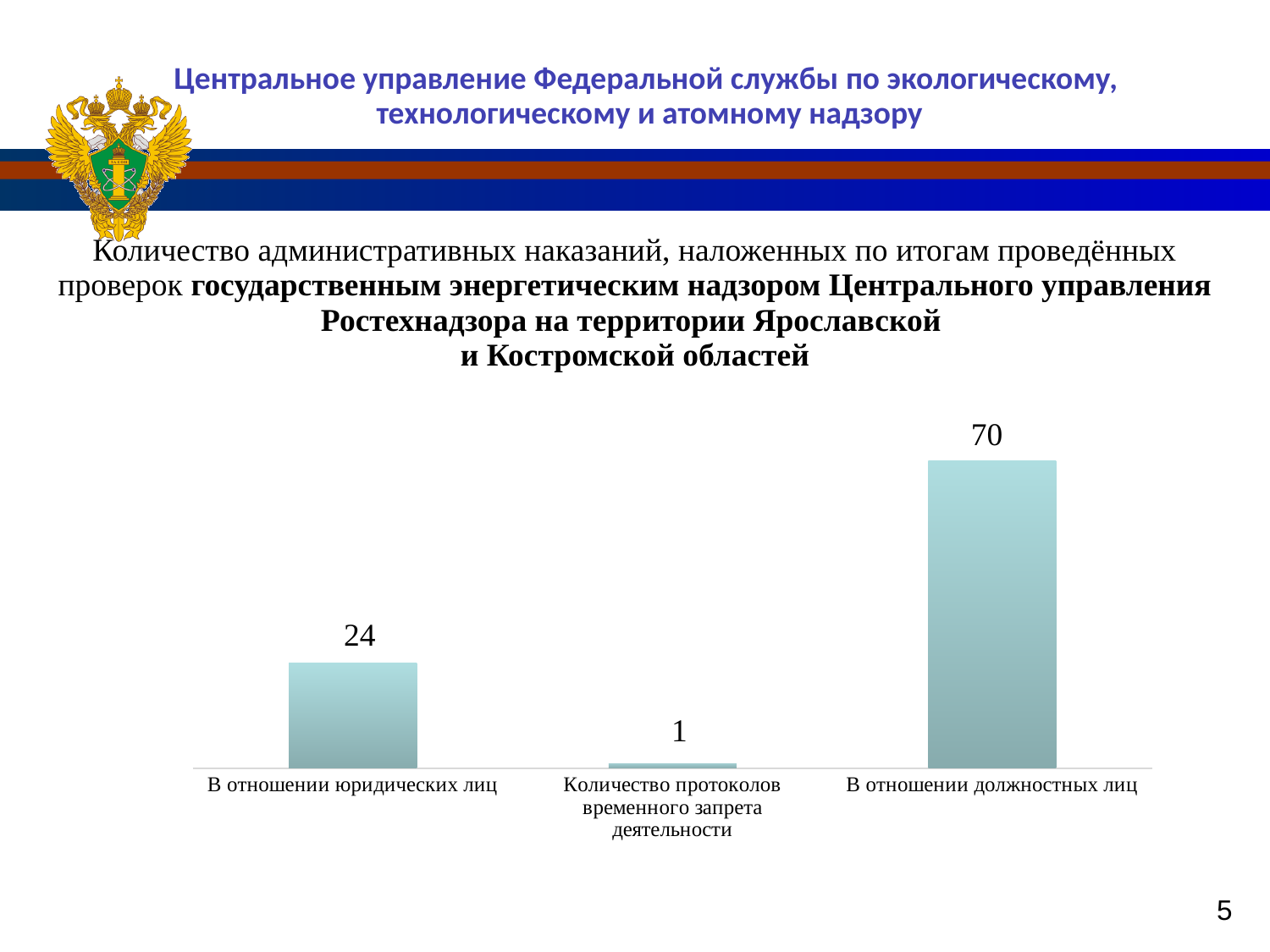
Which category has the highest value? В отношении должностных лиц Which is larger: the value for «В отношении юридических лиц» or for «В отношении должностных лиц»? В отношении должностных лиц What is the value for «В отношении должностных лиц»? 70 What is the total of the three values shown in the chart? 95 What is the difference between the values for «В отношении юридических лиц» and «Количество протоколов временного запрета деятельности»? 23 Does the chart show a legend? No What is the value for «Количество протоколов временного запрета деятельности»? 1 How many categories are shown in the chart? 3 Which category has the lowest value? Количество протоколов временного запрета деятельности What is the difference between the values for «В отношении должностных лиц» and «В отношении юридических лиц»? 46 What is the value for «В отношении юридических лиц»? 24 What kind of chart is shown on the slide? Bar chart